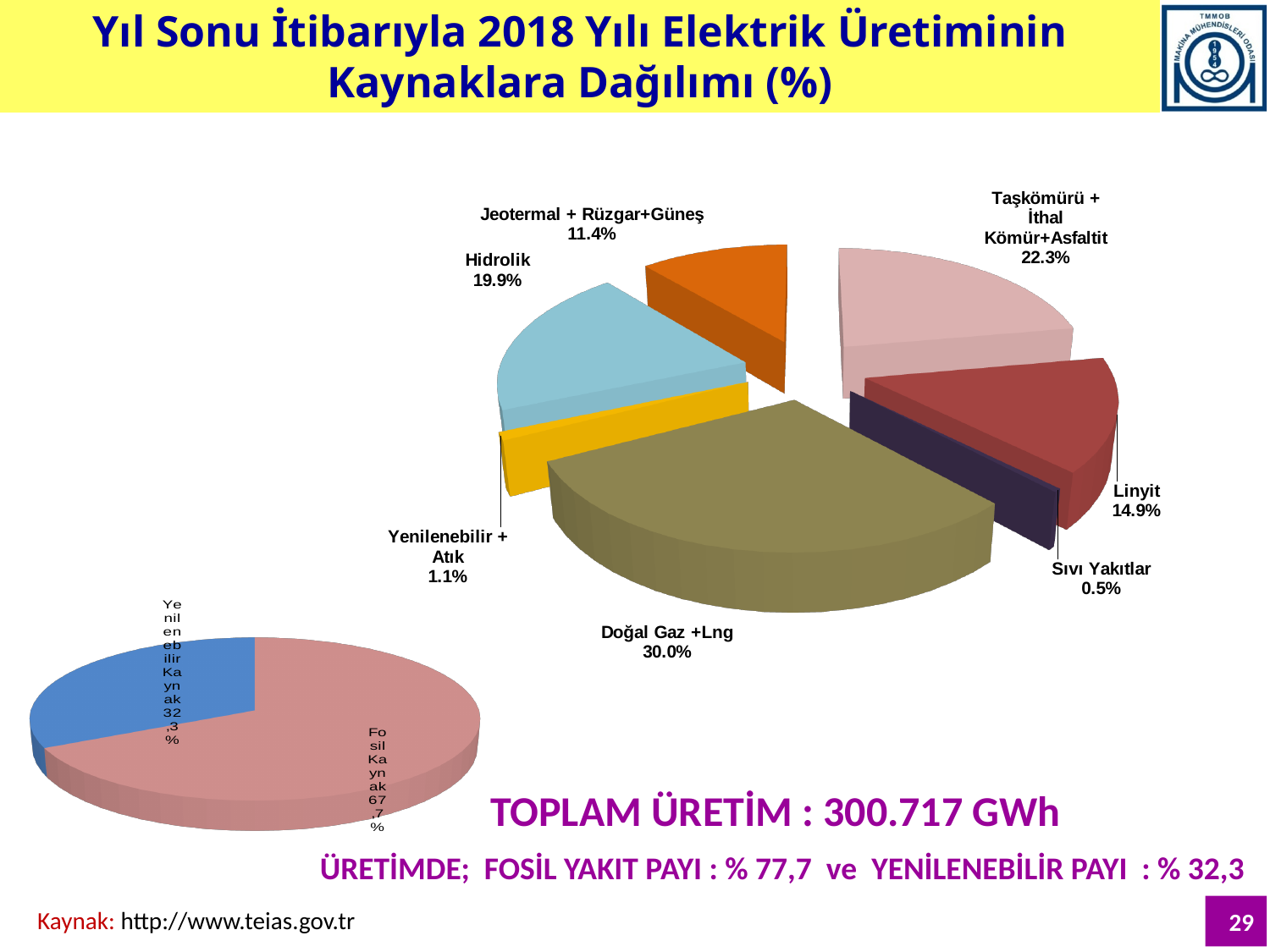
In the small pie chart at the bottom left, what share does Fosil Kaynak have? 67,7% In the large pie chart, what share does Doğal Gaz +Lng have? 30.0% In the large pie chart, what is the difference between the shares of Taşkömürü + İthal Kömür+Asfaltit and Linyit? 7.4% In the large pie chart, what share does Jeotermal + Rüzgar+Güneş have? 11.4% In the large pie chart, which is larger: the share of Hidrolik or the share of Linyit? Hidrolik In the small pie chart at the bottom left, what share does Yenilenebilir Kaynak have? 32,3% In the large pie chart, what share does Linyit have? 14.9% In the large pie chart, which source has the smallest share? Sıvı Yakıtlar In the large pie chart, which source has the largest share? Doğal Gaz +Lng In the large pie chart, what share does Hidrolik have? 19.9% How many slices does the large pie chart have? 7 What type of chart is the large chart on the slide? Pie chart